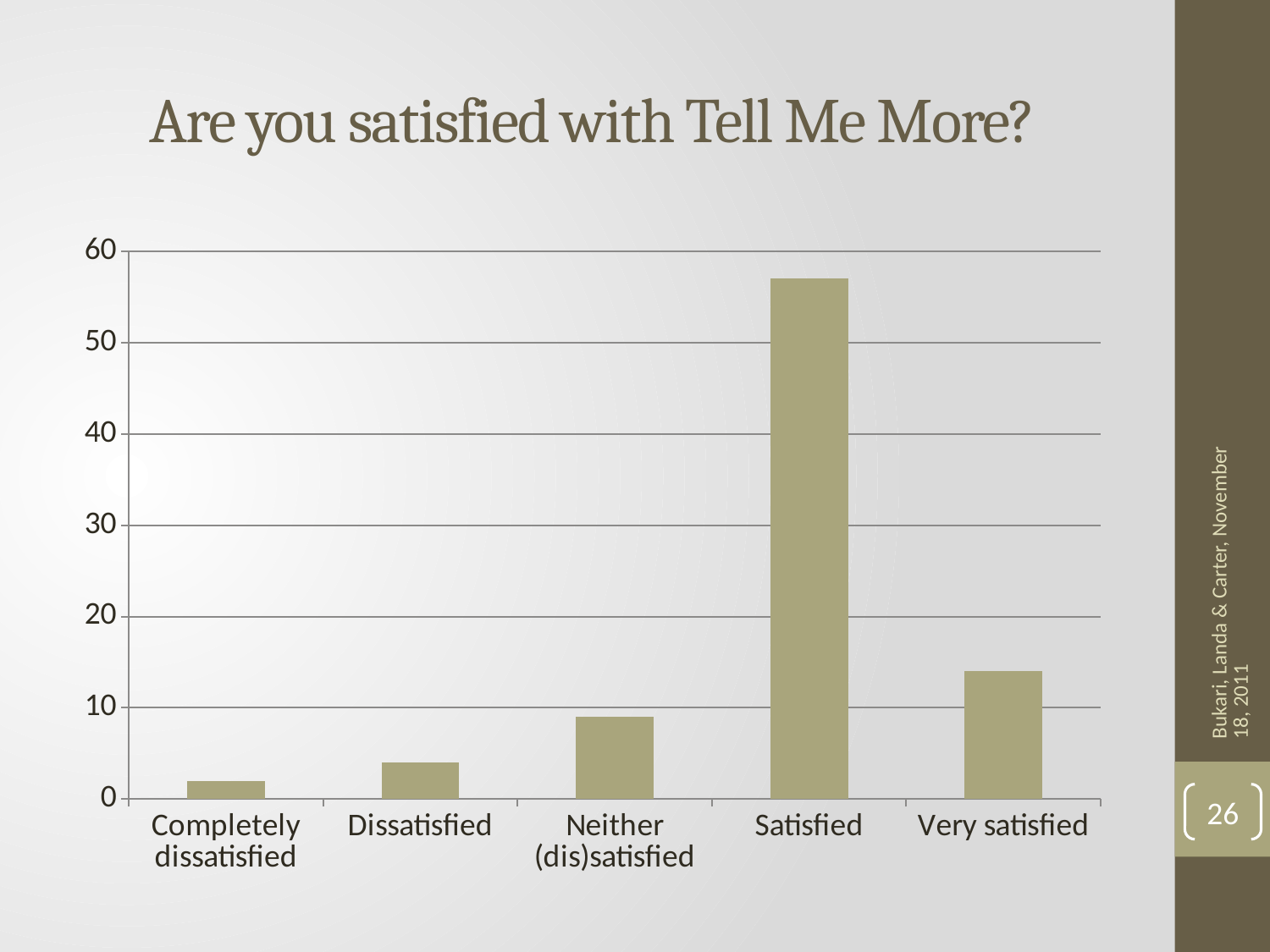
What kind of chart is shown on the slide? bar chart Is the value for Satisfied greater or less than 50? greater Which category has the lowest value in the chart? Completely dissatisfied Which is larger, the value for Very satisfied or the value for Neither (dis)satisfied? Very satisfied Is the value for Neither (dis)satisfied greater or less than 10? less What is the highest value shown on the y axis of the chart? 60 Which category has the highest value in the chart? Satisfied Is the value for Very satisfied greater or less than 10? greater What is the title of the slide containing the chart? Are you satisfied with Tell Me More? How many categories are shown on the x axis of the chart? 5 Which is larger, the value for Dissatisfied or the value for Completely dissatisfied? Dissatisfied